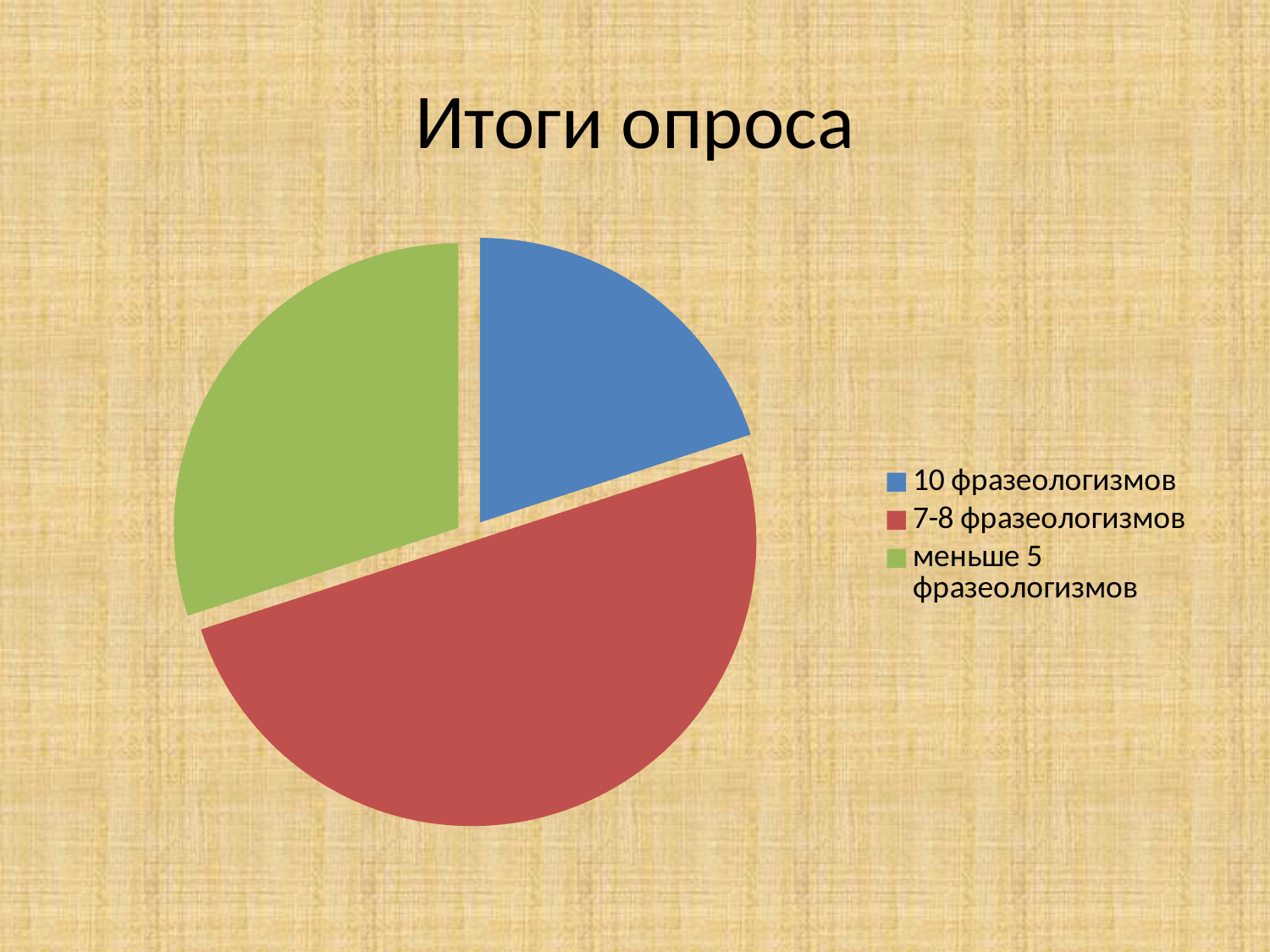
Which category has the largest slice of the pie? 7-8 фразеологизмов How many entries does the legend list? 3 Which category has the smallest slice of the pie? 10 фразеологизмов Which slice is larger: "7-8 фразеологизмов" or "меньше 5 фразеологизмов"? 7-8 фразеологизмов What colour is the slice for "7-8 фразеологизмов"? red What is the title of the chart on the slide? Итоги опроса How many slices does the pie chart have? 3 What kind of chart is shown on the slide? pie chart Which slice is larger: "10 фразеологизмов" or "меньше 5 фразеологизмов"? меньше 5 фразеологизмов